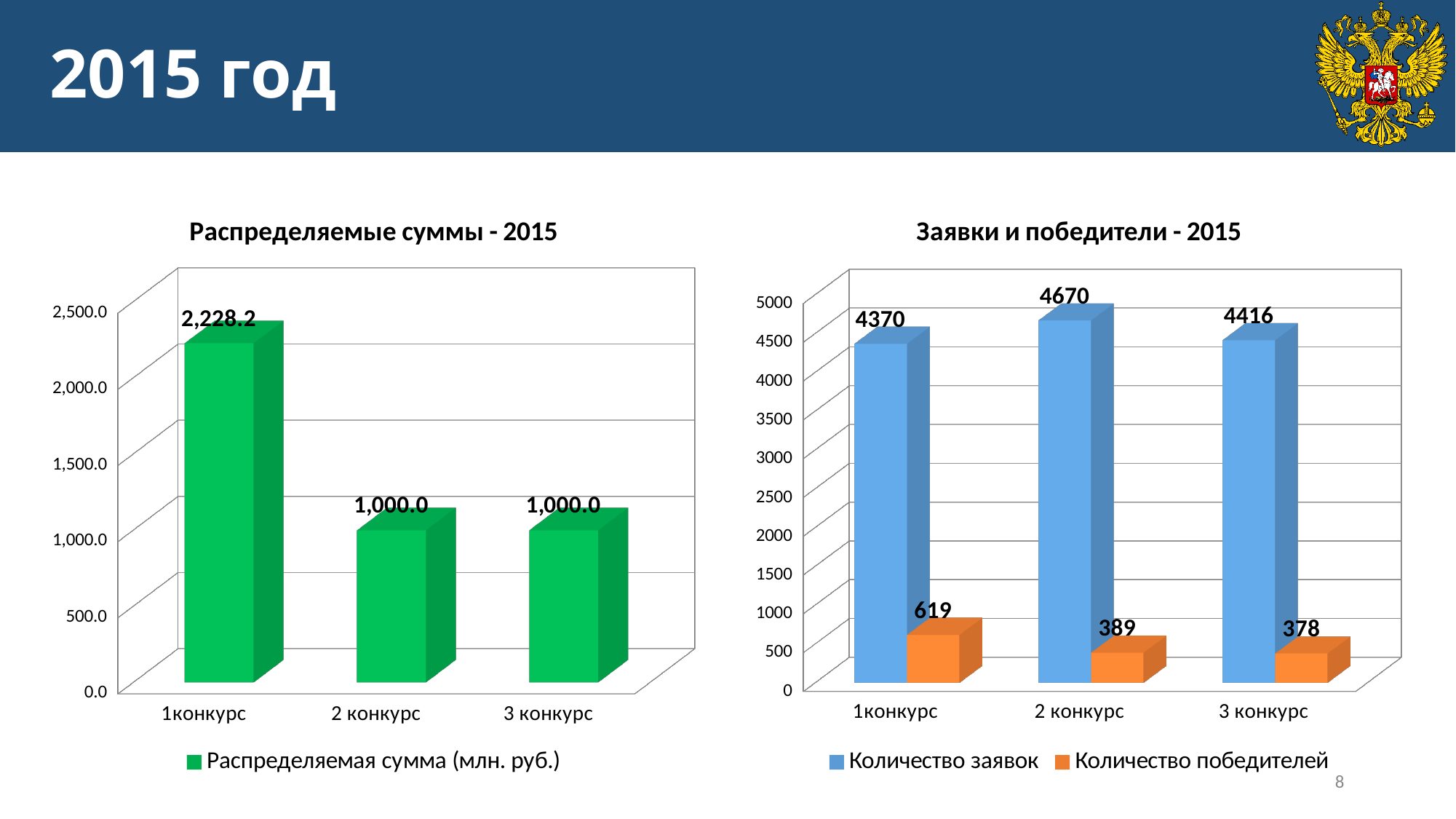
In the chart 'Распределяемые суммы - 2015', which category has the highest value? 1конкурс In the chart 'Распределяемые суммы - 2015', what is the value for 1конкурс? 2,228.2 In the chart 'Заявки и победители - 2015', what is the value of Количество победителей for 3 конкурс? 378 In the chart 'Заявки и победители - 2015', which category has the lowest Количество заявок? 1конкурс In the chart 'Заявки и победители - 2015', which category has the highest Количество победителей? 1конкурс In the chart 'Распределяемые суммы - 2015', how many categories are shown on the x axis? 3 In the chart 'Заявки и победители - 2015', how many series does the legend list? 2 In the chart 'Заявки и победители - 2015', what is the value of Количество заявок for 2 конкурс? 4670 In the chart 'Распределяемые суммы - 2015', what is the difference between the values for 1конкурс and 3 конкурс? 1,228.2 In the chart 'Распределяемые суммы - 2015', what is the value for 2 конкурс? 1,000.0 What kind of chart is 'Заявки и победители - 2015'? Bar chart In the chart 'Заявки и победители - 2015', what is the difference between Количество заявок for 2 конкурс and 1конкурс? 300